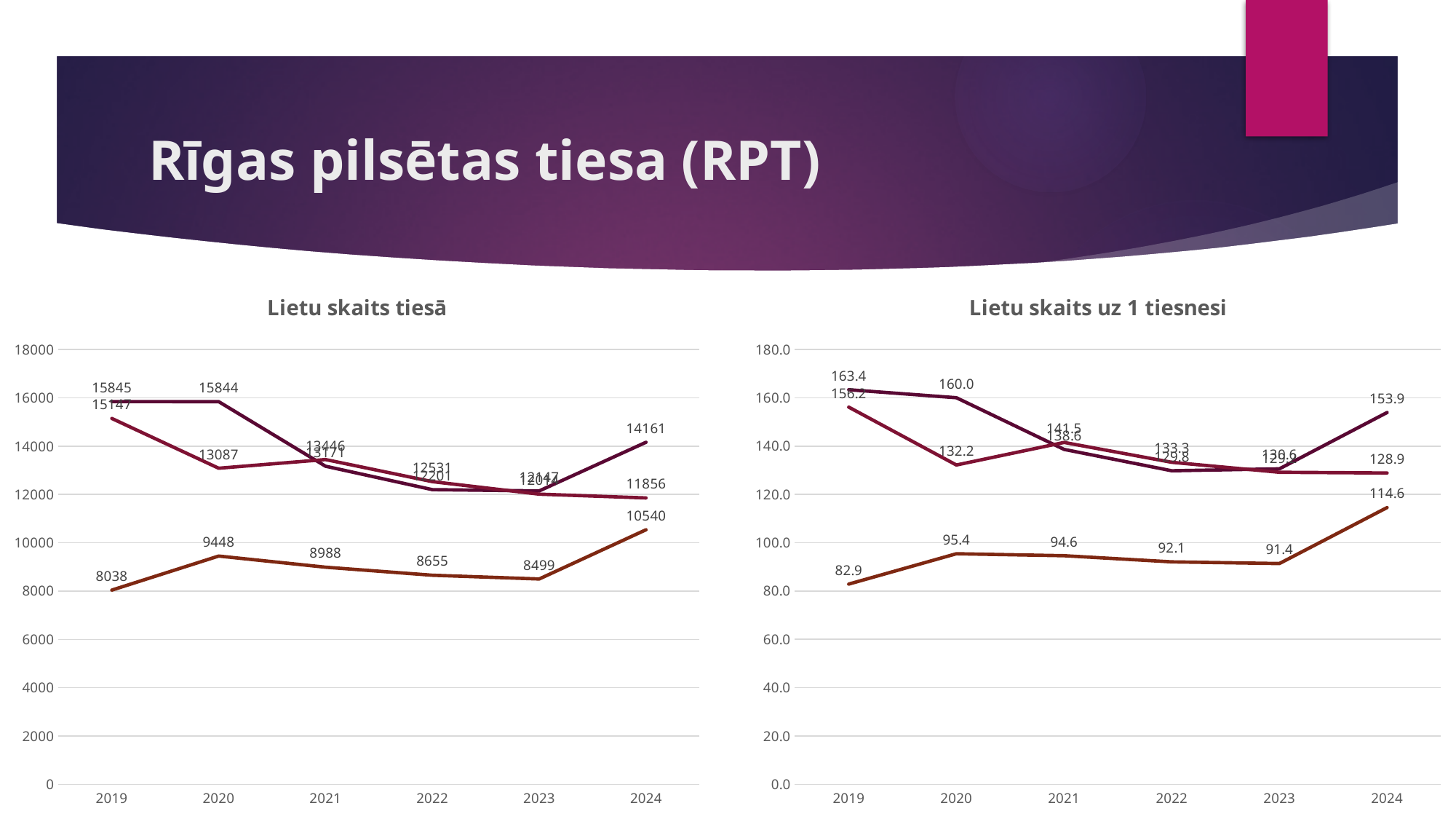
What kind of chart is "Lietu skaits tiesā"? line chart In the "Lietu skaits uz 1 tiesnesi" chart, what is the value of the lowest (orange) line in 2024? 114.6 In the "Lietu skaits uz 1 tiesnesi" chart, what is the value of the lowest (orange) line in 2019? 82.9 In the "Lietu skaits tiesā" chart, in which year does the lowest (orange) line have its lowest value? 2019 In the "Lietu skaits tiesā" chart, what is the difference between the lowest (orange) line's values in 2024 and 2023? 2041 How many years are shown on the x axis of the "Lietu skaits uz 1 tiesnesi" chart? 6 In the "Lietu skaits uz 1 tiesnesi" chart, what is the highest value shown in 2019? 163.4 In the "Lietu skaits tiesā" chart, what is the value of the lowest (orange) line in 2024? 10540 In the "Lietu skaits tiesā" chart, in which year does the lowest (orange) line reach its highest value? 2024 In the "Lietu skaits tiesā" chart, what is the value of the lowest (orange) line in 2019? 8038 In the "Lietu skaits tiesā" chart, does the lowest (orange) line rise or fall from 2023 to 2024? rise In the "Lietu skaits uz 1 tiesnesi" chart, is the lowest (orange) line's value in 2022 greater or less than 100.0? less